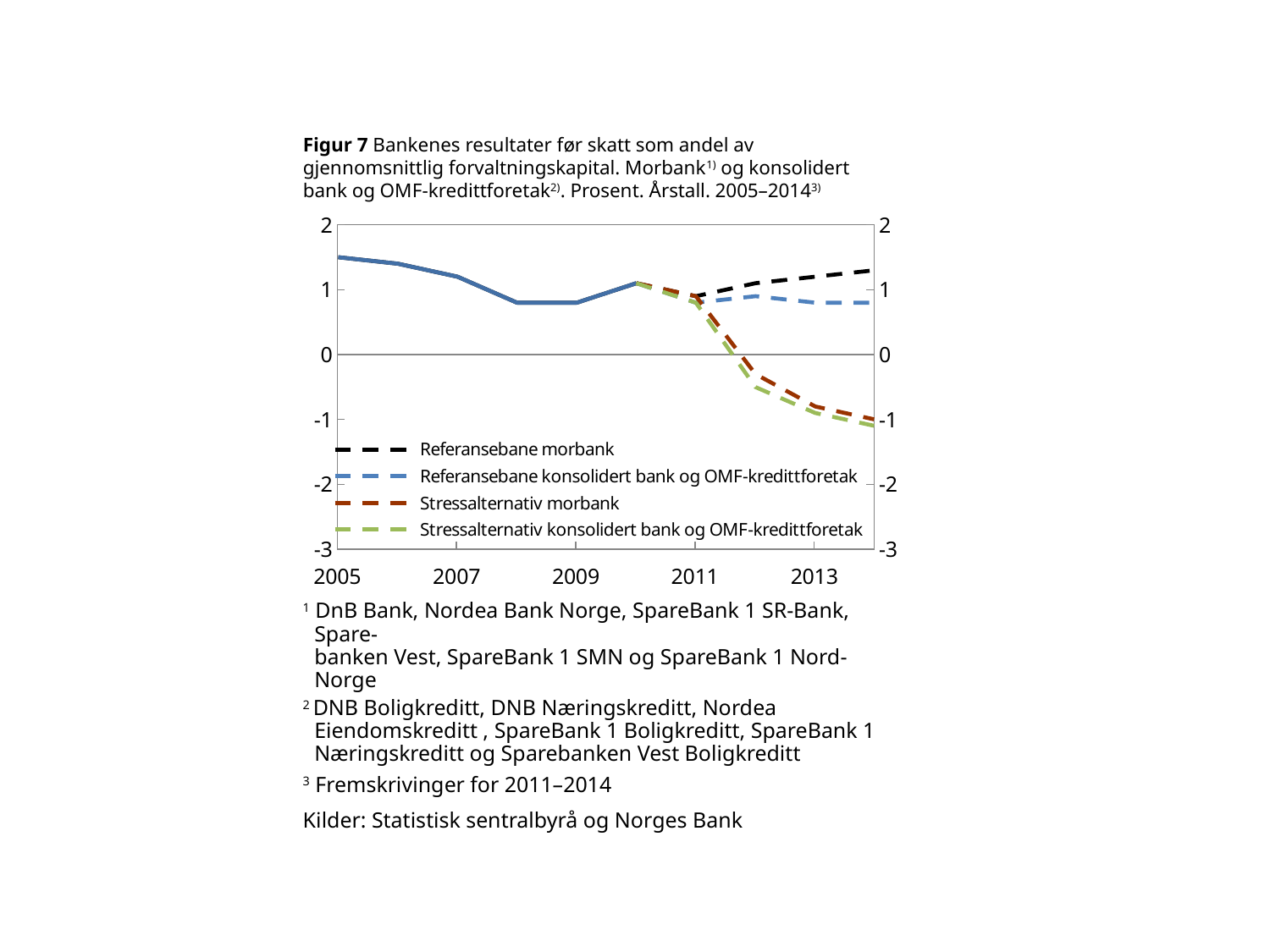
How many year labels are shown on the x axis? 5 Do the values rise or fall from 2005 to 2008? fall Does the Stressalternativ morbank line rise or fall from 2011 to 2014? fall What colour is the Referansebane morbank line in the legend? black Is the value for Stressalternativ morbank in 2014 greater or less than 0? less In 2014, which is larger: Referansebane morbank or Referansebane konsolidert bank og OMF-kredittforetak? Referansebane morbank Is the value in 2005 greater or less than 1? greater Is the value for Referansebane konsolidert bank og OMF-kredittforetak in 2014 greater or less than 0? greater What kind of chart is shown in Figur 7? line chart How many series does the legend list? 4